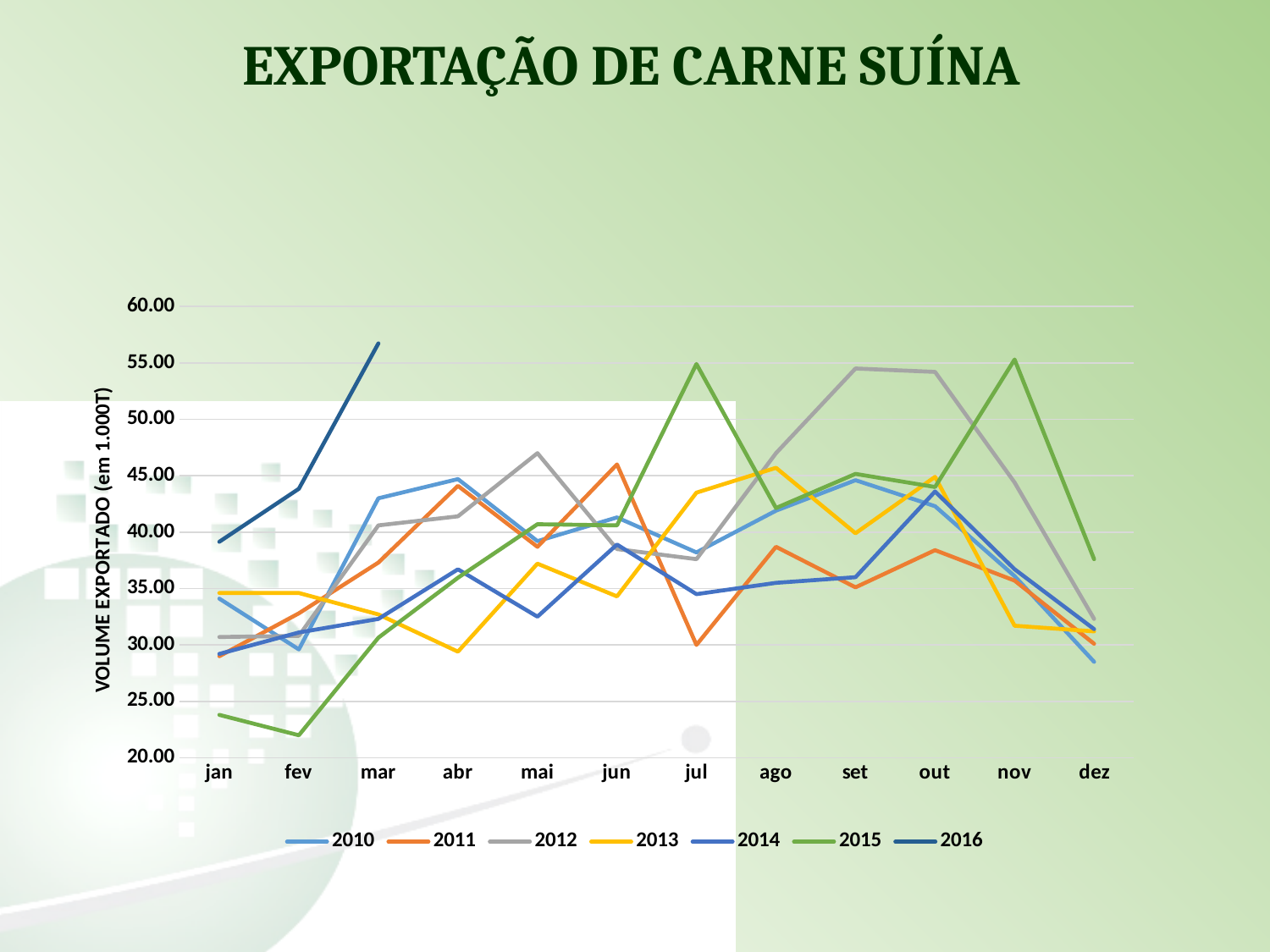
Is the value for 2015 in fev greater or less than 25.00? less How many series does the legend list? 7 Is the value for 2016 in mar greater or less than 55.00? greater Which year's line has the highest value in jan? 2016 What is the title of the y axis? VOLUME EXPORTADO (em 1.000T) What kind of chart is shown on the slide? line chart Which year's line has the lowest value in fev? 2015 Is the value for 2011 in jul greater or less than 35.00? less Does the 2016 line rise or fall from jan to mar? rise In set, which is larger: the value for 2012 or the value for 2011? 2012 Which year's line has the highest value in nov? 2015 How many months are shown along the x axis? 12